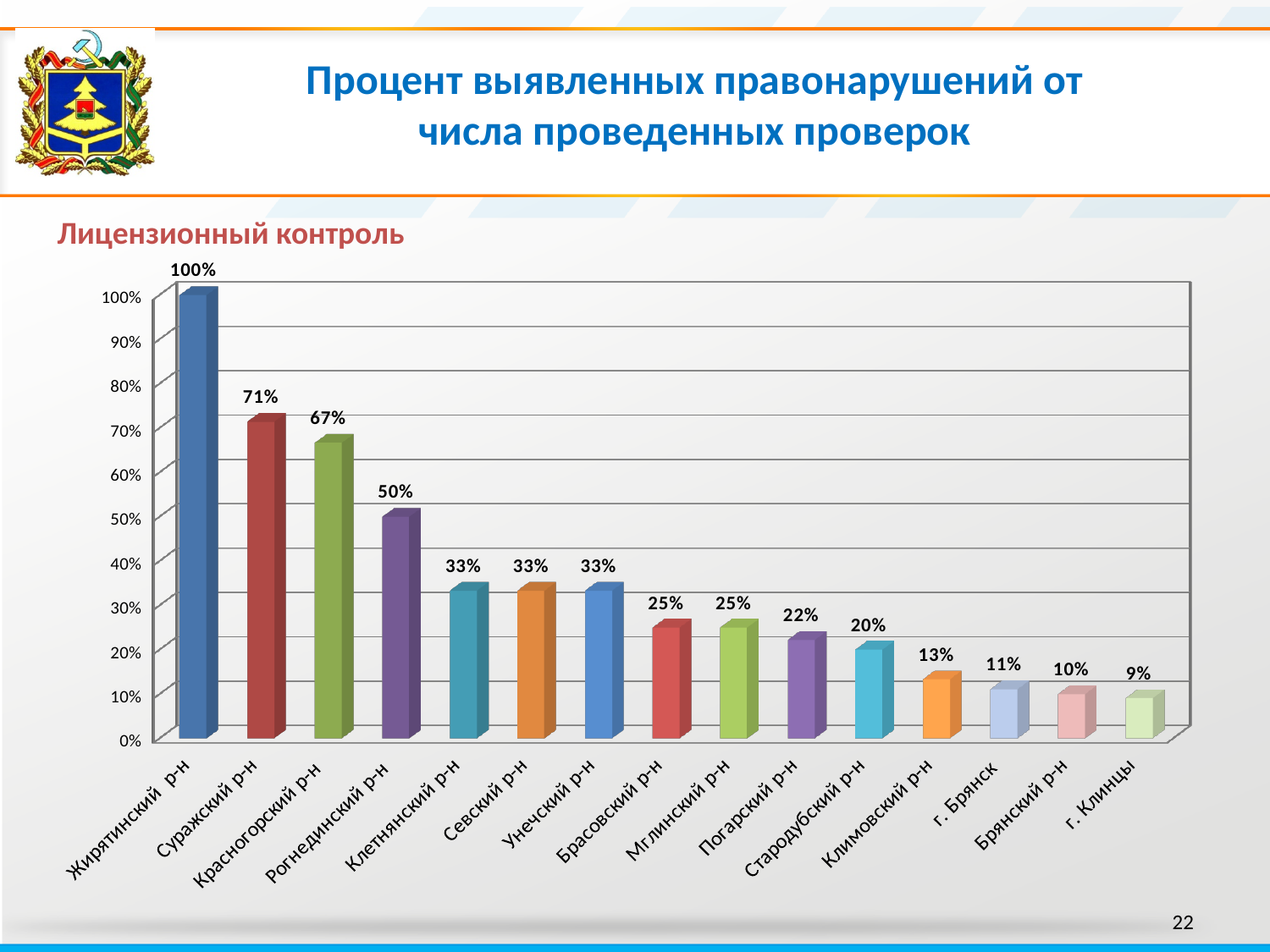
What is the value for Суражский р-н? 71% What is the subtitle shown above the chart? Лицензионный контроль What is the value for Погарский р-н? 22% What is the difference between the values for Красногорский р-н and Рогнединский р-н? 17% How many categories are shown on the x axis? 15 What is the value for г. Брянск? 11% Which category has the highest value? Жирятинский р-н Which category has the lowest value? г. Клинцы Is the value for Брасовский р-н greater or less than 30%? less Do the values rise or fall from left to right along the x axis? fall Which is larger, the value for Стародубский р-н or the value for Климовский р-н? Стародубский р-н What kind of chart is shown on the slide? bar chart